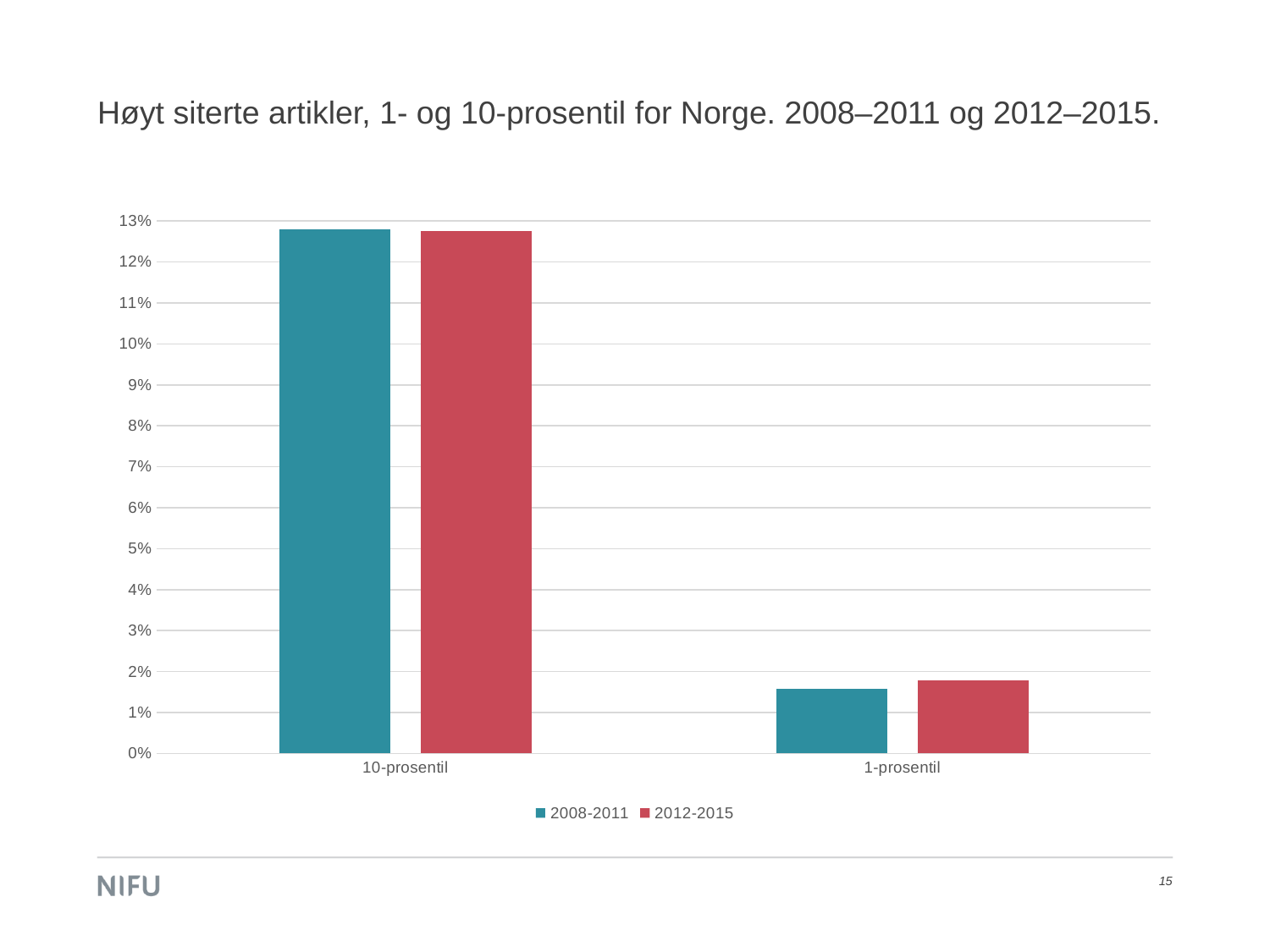
In the 1-prosentil category, which series has the larger value, 2008-2011 or 2012-2015? 2012-2015 What are the two series named in the legend? 2008-2011 and 2012-2015 Is the value for 2008-2011 in the 1-prosentil category greater or less than 2%? less How many categories are shown on the x axis? 2 Is the value for 2008-2011 in the 10-prosentil category greater or less than 12%? greater How many series does the legend list? 2 Which category has the lowest values? 1-prosentil What colour are the bars for the 2012-2015 series? red What kind of chart is shown on the slide? bar chart Is the value for 2012-2015 in the 10-prosentil category greater or less than 10%? greater Which category has the highest values, 10-prosentil or 1-prosentil? 10-prosentil